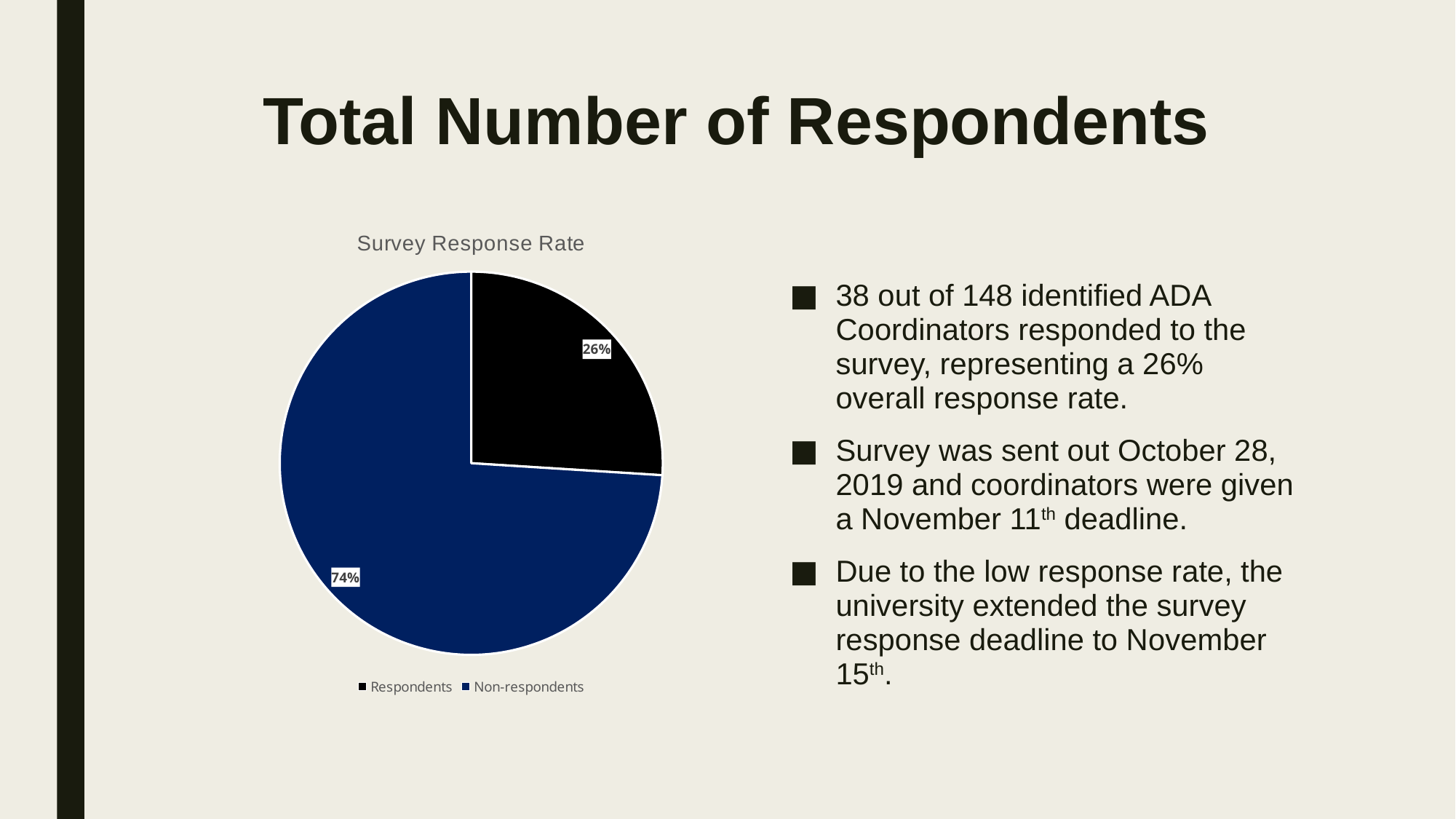
What colour is the Non-respondents slice? dark blue What share of the pie is labelled Respondents? 26% What share of the pie is labelled Non-respondents? 74% What is the difference in percentage points between the Non-respondents and Respondents slices? 48 Which slice is the largest in the pie chart? Non-respondents What is the title of the chart? Survey Response Rate Which slice is larger, Respondents or Non-respondents? Non-respondents How many entries does the legend list? 2 How many slices does the pie chart have? 2 What type of chart is shown on the slide? pie chart Which slice is the smallest in the pie chart? Respondents